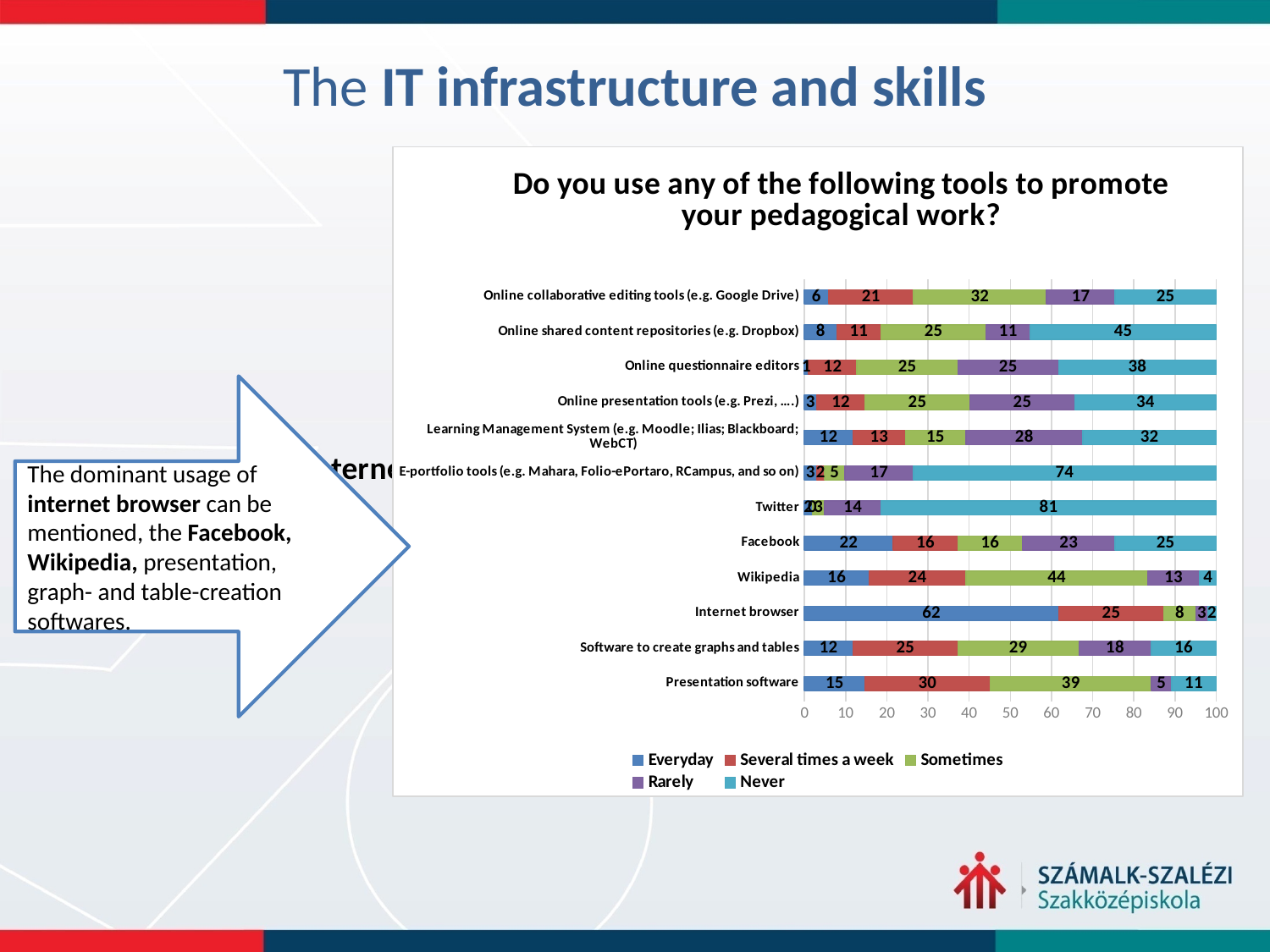
Which tool has the highest 'Never' value? Twitter What is the total of the stacked bar for Presentation software? 100 What is the 'Sometimes' value for Wikipedia? 44 What is the 'Rarely' value for Learning Management System (e.g. Moodle; Ilias; Blackboard; WebCT)? 28 How many tool categories are plotted in the chart? 12 Which has the larger 'Several times a week' value, Presentation software or Facebook? Presentation software What is the 'Everyday' value for Internet browser? 62 What kind of chart is shown on the slide? Stacked bar chart Which tool has the highest 'Everyday' value? Internet browser What is the difference between the 'Never' value for Online shared content repositories (e.g. Dropbox) and the 'Never' value for Online collaborative editing tools (e.g. Google Drive)? 20 What is the 'Never' value for Twitter? 81 How many series does the legend list? 5